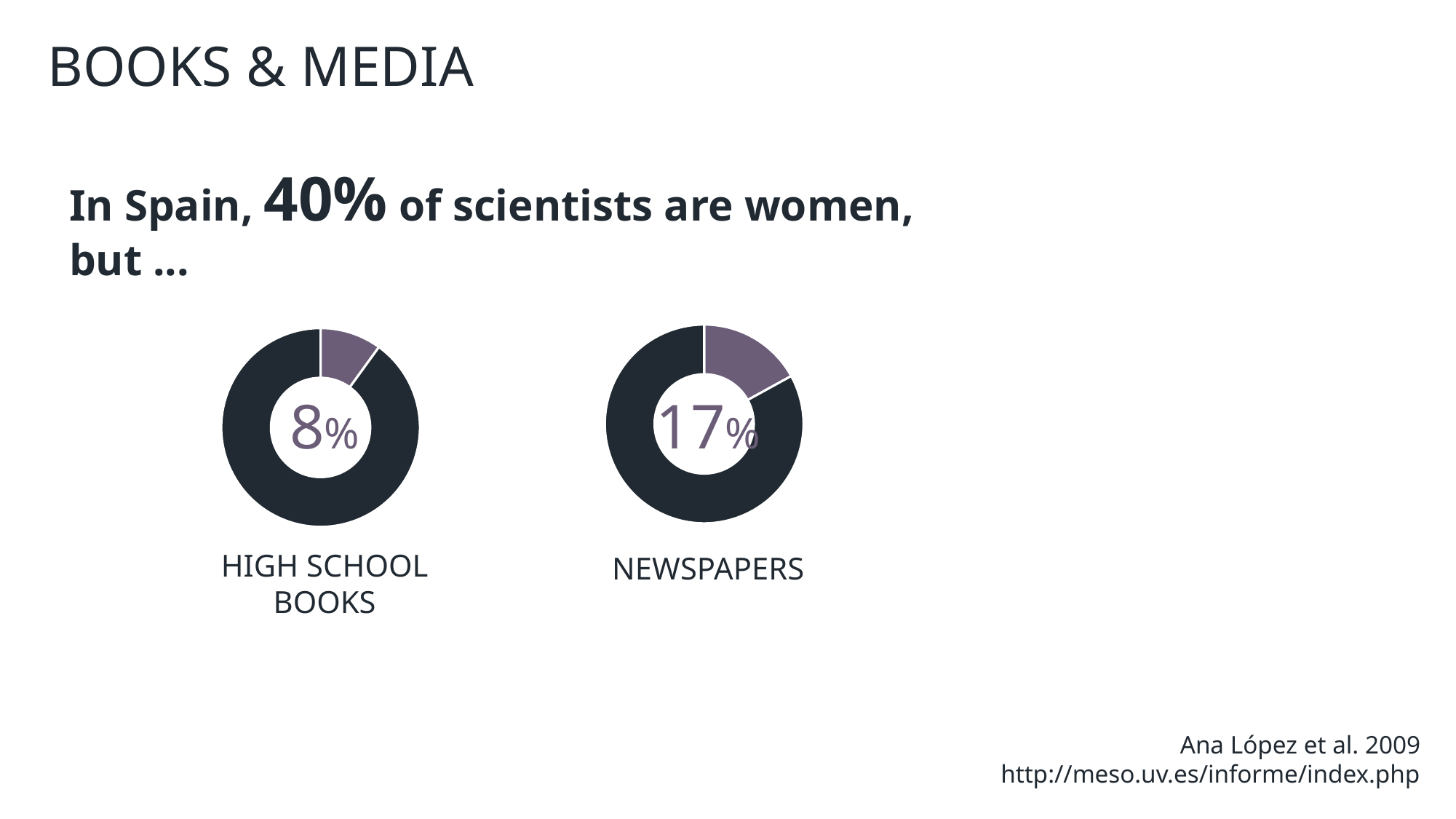
What percentage is shown in the centre of the HIGH SCHOOL BOOKS chart? 8% Which chart shows the higher percentage, HIGH SCHOOL BOOKS or NEWSPAPERS? NEWSPAPERS What is the title of the slide containing the two doughnut charts? BOOKS & MEDIA How many doughnut charts are shown on the slide? 2 Which chart shows the lower percentage, HIGH SCHOOL BOOKS or NEWSPAPERS? HIGH SCHOOL BOOKS What percentage is shown in the centre of the NEWSPAPERS chart? 17% What colour is the highlighted slice in both doughnut charts? Purple What kind of chart is used for HIGH SCHOOL BOOKS and NEWSPAPERS? Doughnut (pie) chart In the NEWSPAPERS chart, what share of the ring is the purple slice? 17% What is the difference between the percentage in the NEWSPAPERS chart and the percentage in the HIGH SCHOOL BOOKS chart? 9%